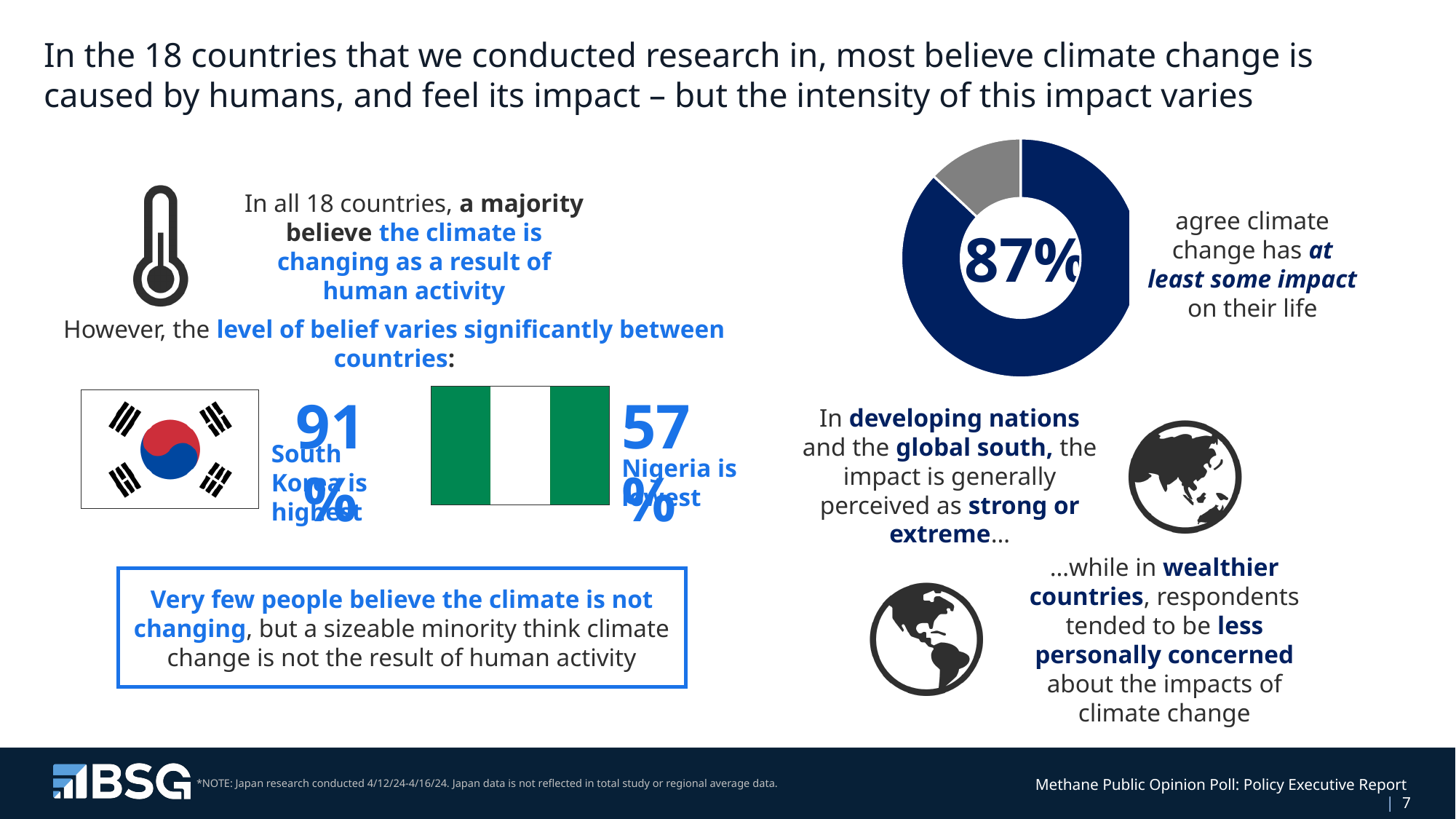
What is the difference between the South Korea and Nigeria percentages shown on the slide? 34 percentage points Which country is shown as lowest in belief that the climate is changing as a result of human activity? Nigeria How many segments does the donut chart have? 2 What colour is the segment of the donut chart representing the 87%? Dark blue What percentage is shown for South Korea? 91% What percentage is shown in the centre of the donut chart? 87% Is the value shown in the donut chart greater or less than 50%? greater What share of the donut chart is not covered by the 87% segment? 13% Which segment of the donut chart is larger, the dark blue one or the grey one? The dark blue one What kind of chart is shown on the right side of the slide? Donut (pie) chart What does the 87% in the donut chart represent? Agree climate change has at least some impact on their life Which country is shown as highest in belief that the climate is changing as a result of human activity? South Korea